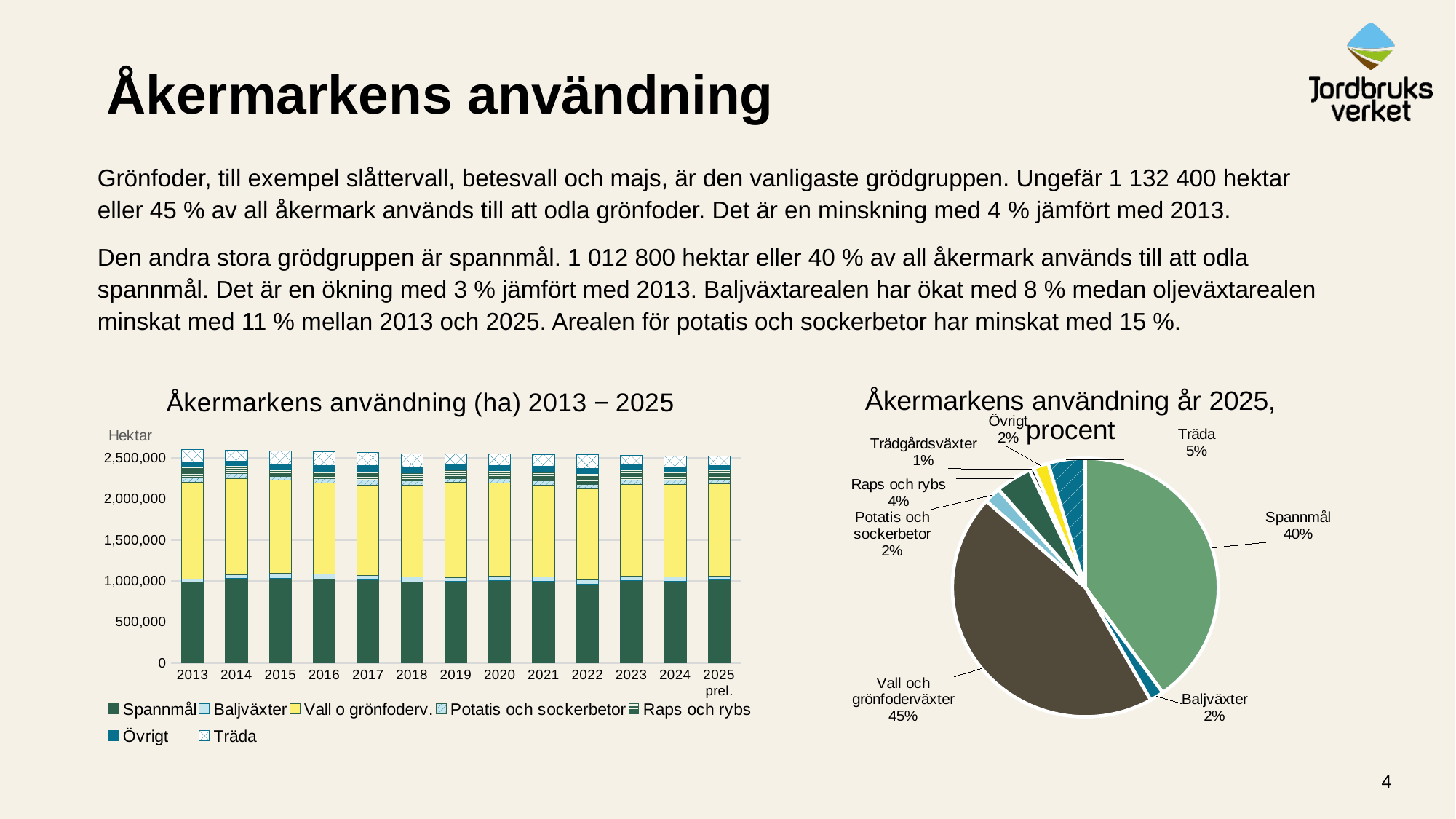
On the pie chart 'Åkermarkens användning år 2025, procent', which has the larger share, Raps och rybs or Träda? Träda On the bar chart 'Åkermarkens användning (ha) 2013 − 2025', what unit is shown on the y axis label? Hektar On the pie chart 'Åkermarkens användning år 2025, procent', which category has the smallest share? Trädgårdsväxter On the bar chart 'Åkermarkens användning (ha) 2013 − 2025', how many series does the legend list? 7 On the pie chart 'Åkermarkens användning år 2025, procent', what share does Träda have? 5% On the bar chart 'Åkermarkens användning (ha) 2013 − 2025', how many years are shown on the x axis? 13 On the pie chart 'Åkermarkens användning år 2025, procent', what share does Spannmål have? 40% On the bar chart 'Åkermarkens användning (ha) 2013 − 2025', is the total height of the 2013 bar greater or less than 2,000,000? greater On the pie chart 'Åkermarkens användning år 2025, procent', how many percentage points larger is the share of Vall och grönfoderväxter than the share of Spannmål? 5 percentage points On the pie chart 'Åkermarkens användning år 2025, procent', how many slices are shown? 8 What kind of chart is 'Åkermarkens användning (ha) 2013 − 2025'? Stacked bar chart On the pie chart 'Åkermarkens användning år 2025, procent', which category has the largest share? Vall och grönfoderväxter